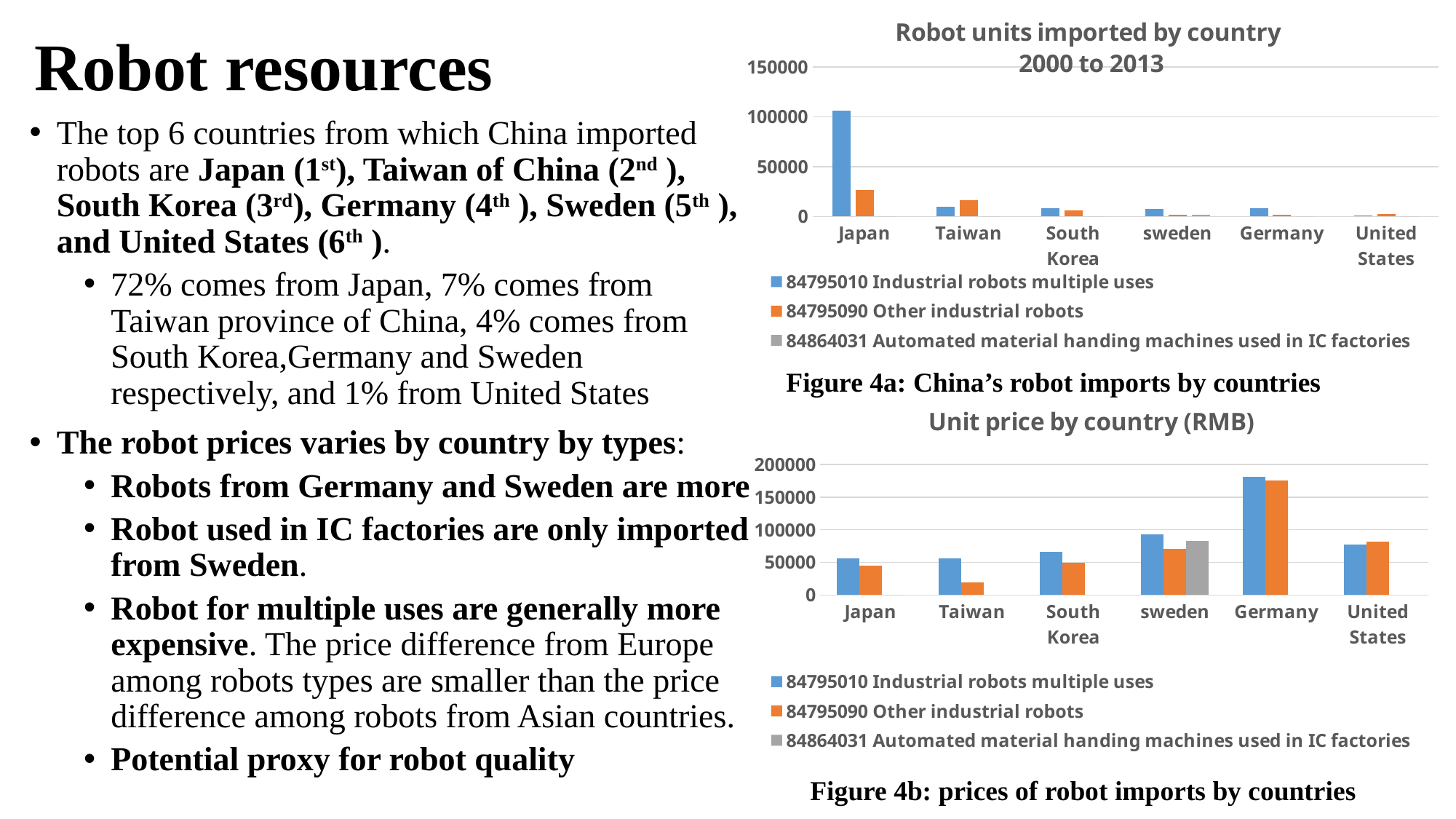
In the 'Robot units imported by country 2000 to 2013' chart, which country has the highest value for '84795010 Industrial robots multiple uses'? Japan In the 'Unit price by country (RMB)' chart, which country is the only one with a bar for '84864031 Automated material handing machines used in IC factories'? sweden How many series does the legend of the 'Robot units imported by country 2000 to 2013' chart list? 3 How many countries are shown on the x axis of the 'Unit price by country (RMB)' chart? 6 In the 'Robot units imported by country 2000 to 2013' chart, is the value for Taiwan in the '84795090 Other industrial robots' series greater or less than 50000? less In the 'Unit price by country (RMB)' chart, which is larger for Taiwan: '84795010 Industrial robots multiple uses' or '84795090 Other industrial robots'? 84795010 Industrial robots multiple uses In the 'Unit price by country (RMB)' chart, which country has the lowest unit price for '84795090 Other industrial robots'? Taiwan In the 'Unit price by country (RMB)' chart, is the value for Taiwan in the '84795090 Other industrial robots' series greater or less than 50000? less In the 'Unit price by country (RMB)' chart, is the value for Germany in the '84795010 Industrial robots multiple uses' series greater or less than 150000? greater In the 'Unit price by country (RMB)' chart, which country has the highest unit price for '84795010 Industrial robots multiple uses'? Germany What type of chart is the 'Robot units imported by country 2000 to 2013' chart? bar chart